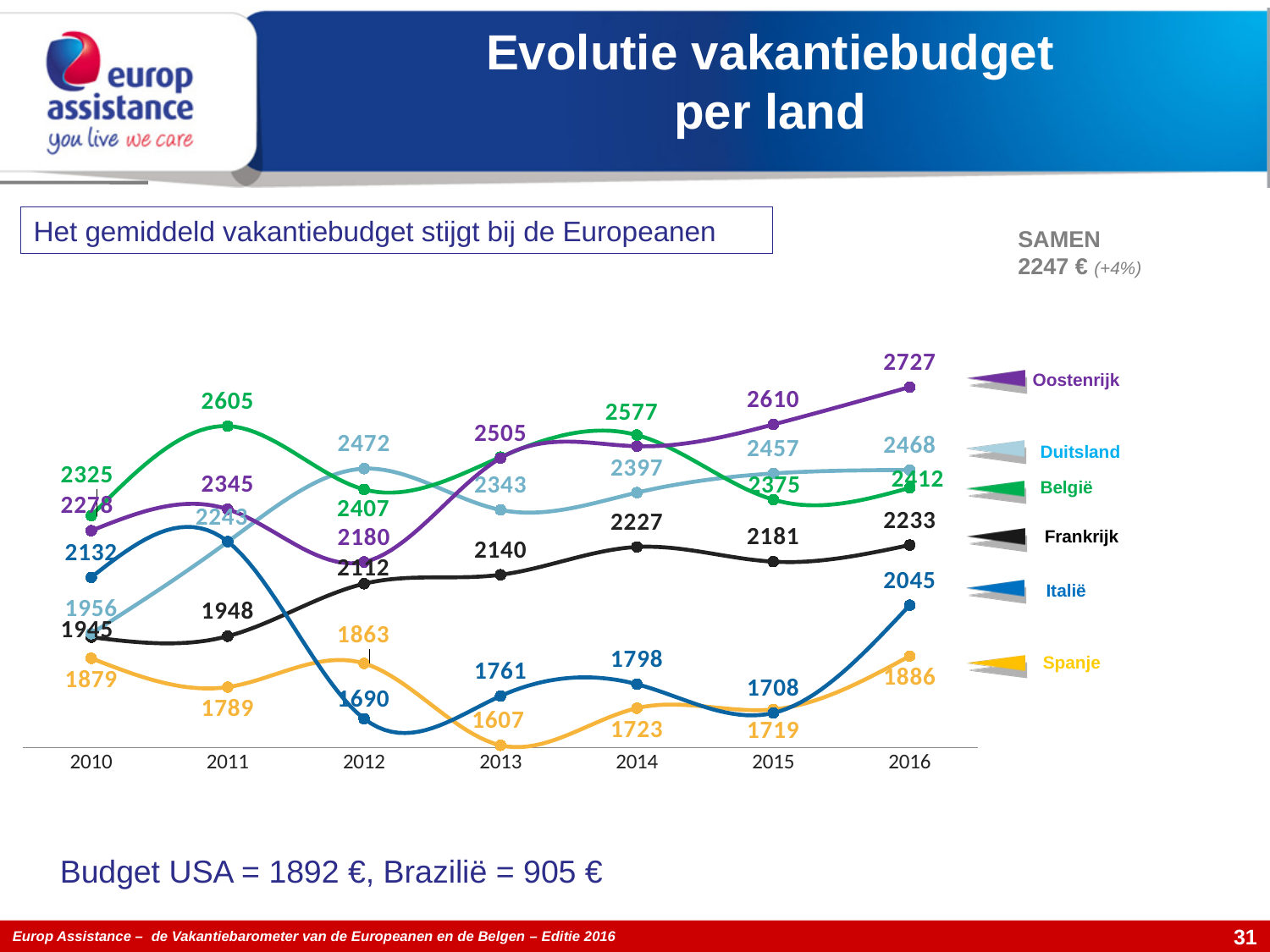
What is the difference between the 2016 values for Oostenrijk and Spanje? 841 What kind of chart is shown on the slide? line chart How many countries does the legend list? 6 What is the difference between the Duitsland values for 2016 and 2015? 11 Does the value for Frankrijk rise or fall from 2010 to 2013? rise What is the value for Italië in 2012? 1690 What is the value for Oostenrijk in 2016? 2727 How many years are shown on the x axis? 7 Which country has the lowest value in 2016? Spanje What is the value for Spanje in 2013? 1607 Which country has the highest value in 2016? Oostenrijk In 2011, which is larger: the value for België or the value for Oostenrijk? België